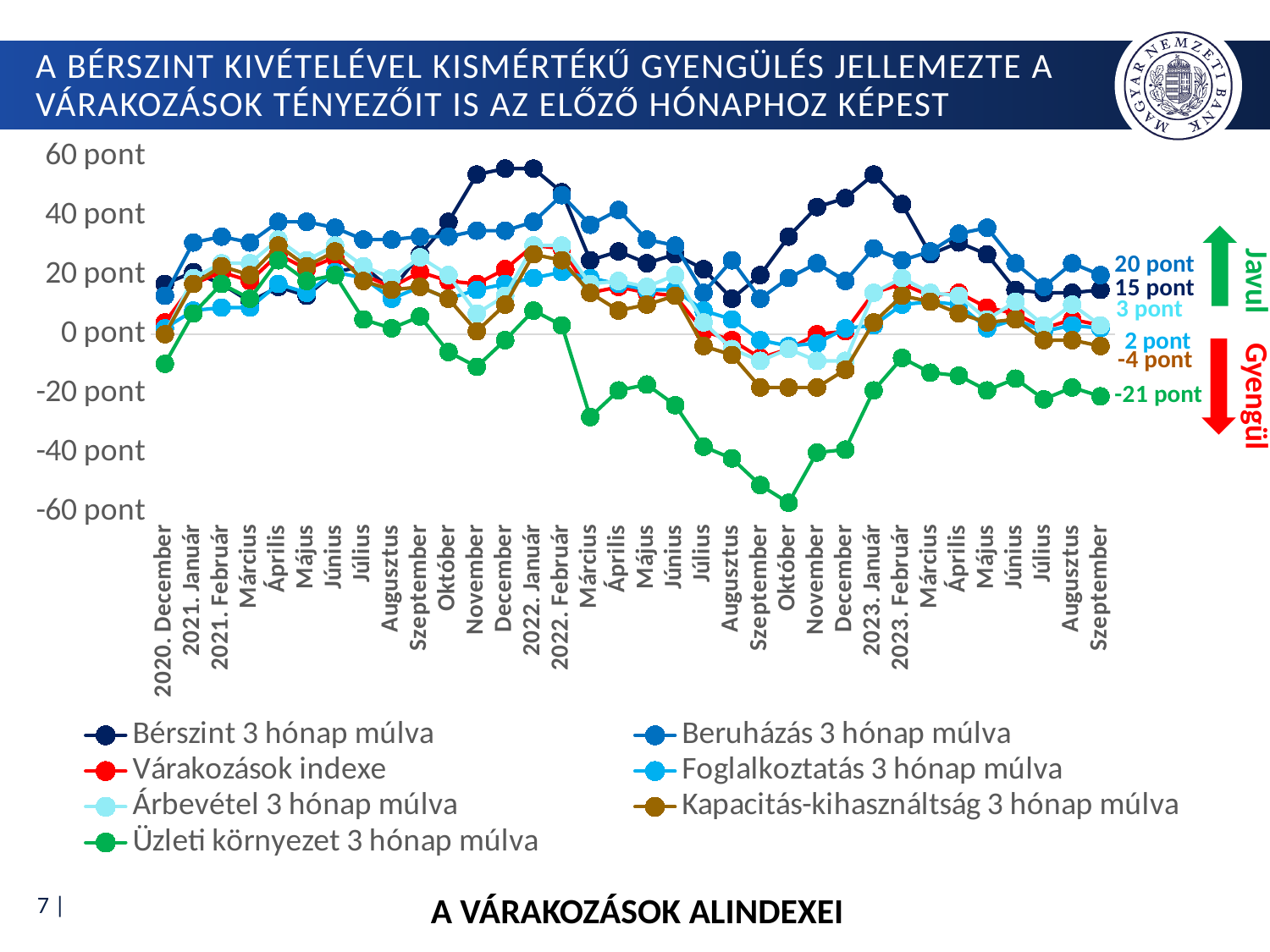
Is the value for Üzleti környezet 3 hónap múlva in 2022 Október greater or less than -40 pont? less What is the difference between Beruházás 3 hónap múlva and Bérszint 3 hónap múlva at the last point (2023 Szeptember)? 5 pont At the last point (2023 Szeptember), which is larger: Árbevétel 3 hónap múlva or Foglalkoztatás 3 hónap múlva? Árbevétel 3 hónap múlva Which series has the lowest value at the last point (2023 Szeptember)? Üzleti környezet 3 hónap múlva What is the value of Bérszint 3 hónap múlva at the last point (2023 Szeptember)? 15 pont What is the value of Kapacitás-kihasználtság 3 hónap múlva at the last point (2023 Szeptember)? -4 pont What is the value of Üzleti környezet 3 hónap múlva at the last point (2023 Szeptember)? -21 pont What is the value of Beruházás 3 hónap múlva at the last point (2023 Szeptember)? 20 pont What kind of chart is shown on the slide? line chart Which series has the highest value at the last point (2023 Szeptember)? Beruházás 3 hónap múlva What is the title of the chart shown at the bottom of the slide? A VÁRAKOZÁSOK ALINDEXEI How many series does the legend list? 7